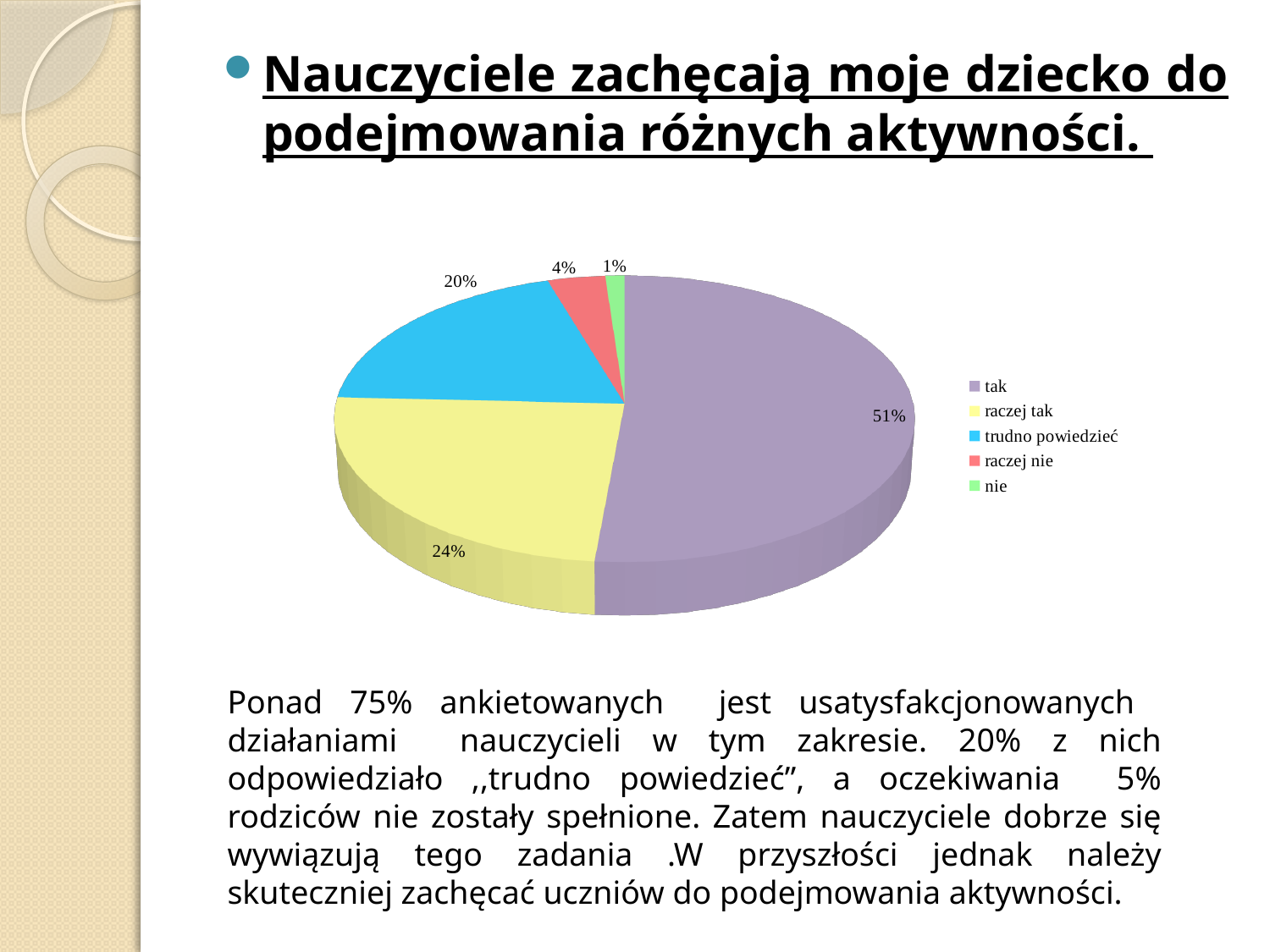
What share of the pie does the "raczej tak" slice represent? 24% Which category has the largest slice of the pie? tak What share of the pie does the "nie" slice represent? 1% What kind of chart is shown on the slide? pie chart What colour is the "trudno powiedzieć" slice? blue What share of the pie does the "tak" slice represent? 51% How many categories does the pie chart show? 5 Which category has the smallest slice of the pie? nie Which slice is larger, "raczej tak" or "trudno powiedzieć"? raczej tak What is the difference in percentage points between the "tak" and "raczej tak" slices? 27%